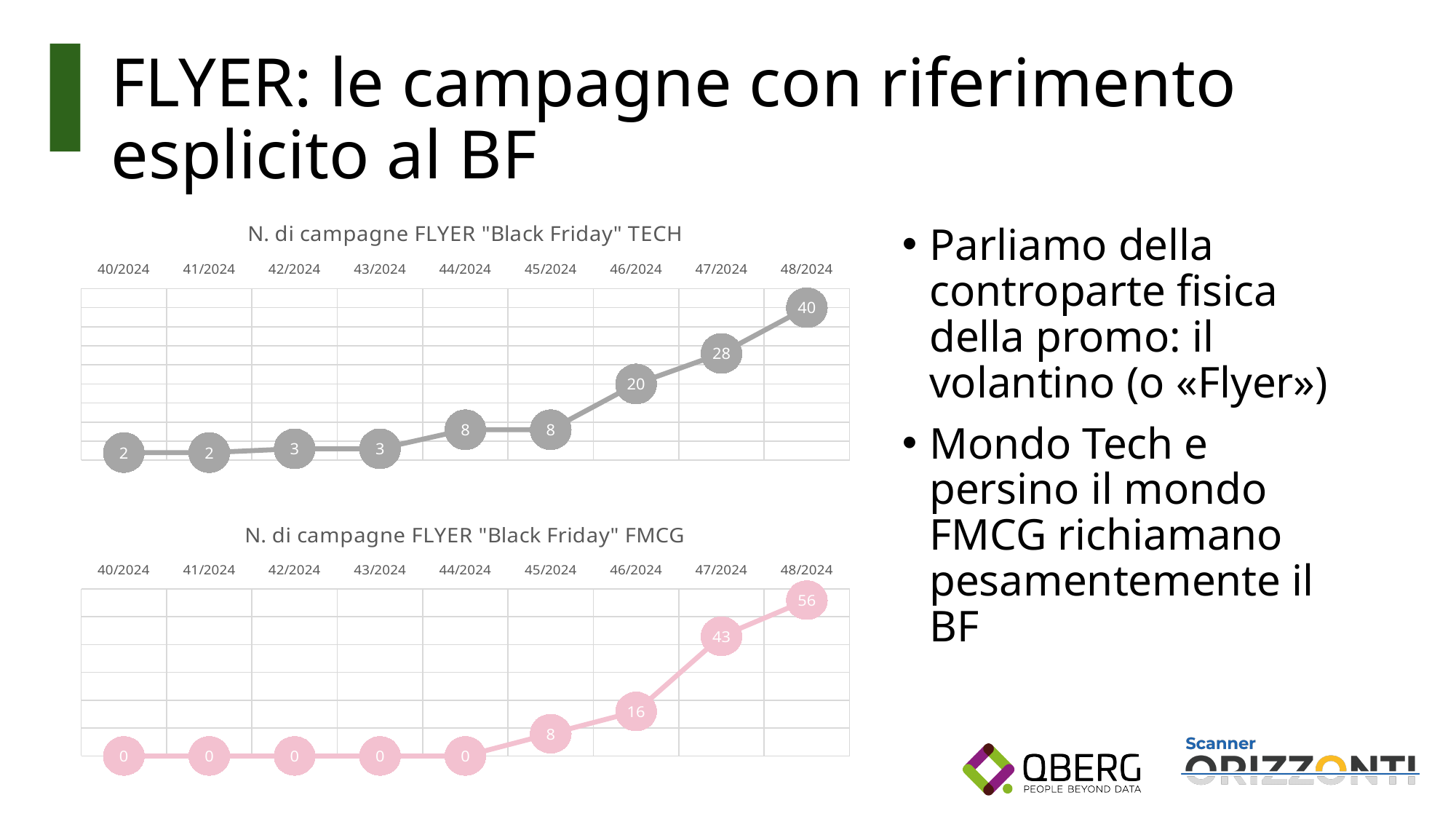
In the TECH chart (top), do the values rise or fall from 40/2024 to 48/2024? Rise In the chart titled 'N. di campagne FLYER "Black Friday" TECH', what is the value for 46/2024? 20 How many data points are plotted in the TECH chart (top)? 9 In the TECH chart (top), which week has the highest value? 48/2024 What is the title of the top chart? N. di campagne FLYER "Black Friday" TECH In the TECH chart (top), what is the difference between the values for 48/2024 and 47/2024? 12 In the FMCG chart (bottom), what is the value for 44/2024? 0 In the chart titled 'N. di campagne FLYER "Black Friday" FMCG', what is the value for 47/2024? 43 In the FMCG chart (bottom), which week has the highest value? 48/2024 In the FMCG chart (bottom), what is the difference between the values for 48/2024 and 46/2024? 40 Which is larger: the value for 48/2024 in the TECH chart or the value for 48/2024 in the FMCG chart? FMCG chart (56) What kind of chart is the FMCG chart (bottom)? Line chart